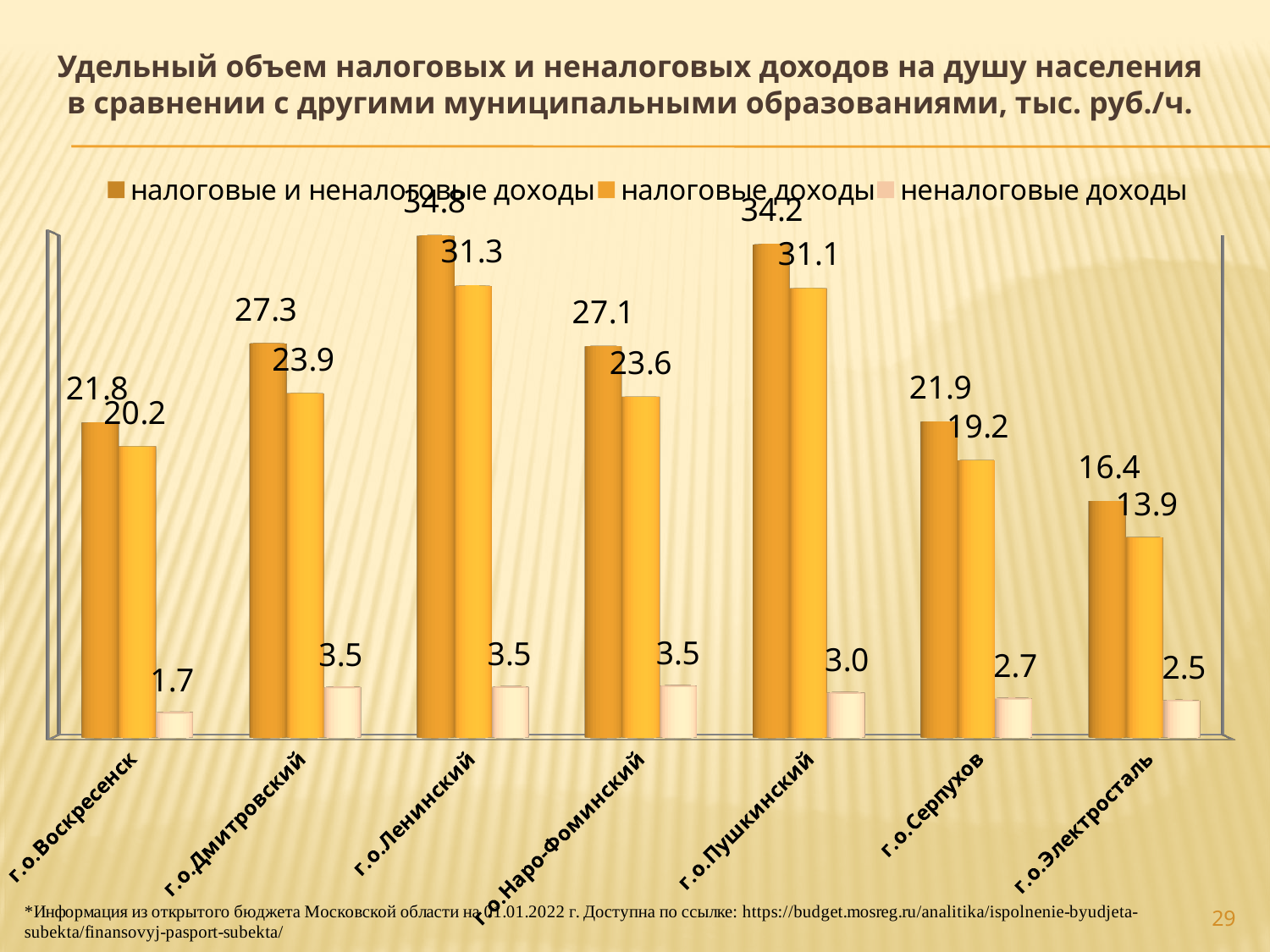
Which municipality has the highest value of налоговые и неналоговые доходы? г.о.Ленинский How many municipalities are shown on the x axis? 7 Which municipality has the lowest value of налоговые доходы? г.о.Электросталь What is the difference in неналоговые доходы between г.о.Ленинский and г.о.Электросталь? 1.0 What kind of chart is shown on the slide? bar chart What is the value of налоговые доходы for г.о.Серпухов? 19.2 Which is larger: налоговые доходы for г.о.Дмитровский or for г.о.Наро-Фоминский? г.о.Дмитровский What is the value of налоговые и неналоговые доходы for г.о.Ленинский? 34.8 What is the difference between налоговые и неналоговые доходы and налоговые доходы for г.о.Пушкинский? 3.1 How many series does the legend list? 3 What is the value of неналоговые доходы for г.о.Воскресенск? 1.7 What is the unit of measurement stated in the chart title? тыс. руб./ч.